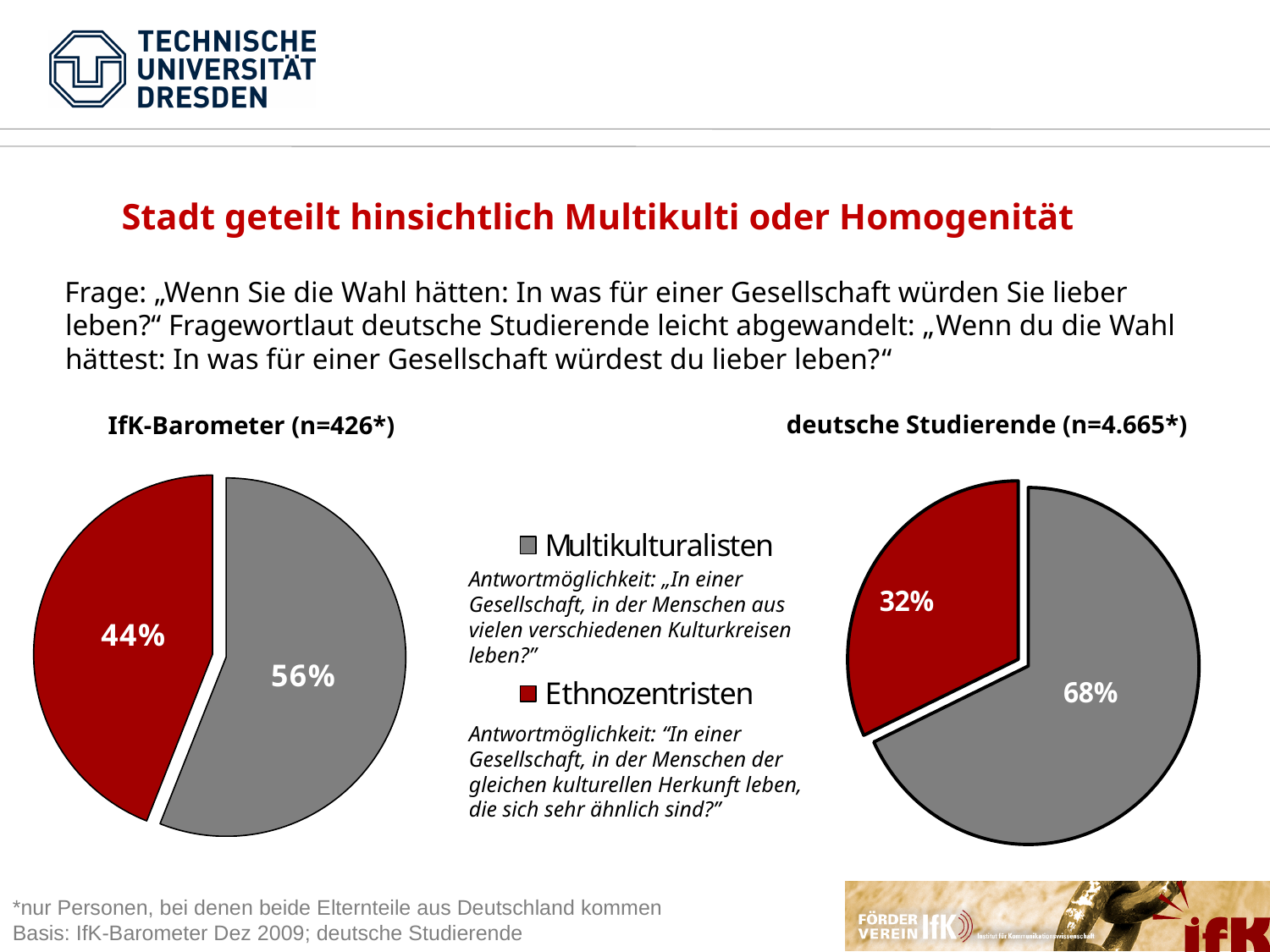
In the IfK-Barometer (n=426*) pie chart, which group has the larger share? Multikulturalisten Which colour represents the Ethnozentristen in the pie charts? Red In the deutsche Studierende (n=4.665*) pie chart, what share do the Multikulturalisten have? 68% In the IfK-Barometer (n=426*) pie chart, what is the difference in percentage points between Multikulturalisten and Ethnozentristen? 12 percentage points In the deutsche Studierende (n=4.665*) pie chart, what share do the Ethnozentristen have? 32% In the deutsche Studierende (n=4.665*) pie chart, which group has the smaller share? Ethnozentristen What type of chart is used on this slide? Pie chart In the deutsche Studierende (n=4.665*) pie chart, what is the difference in percentage points between Multikulturalisten and Ethnozentristen? 36 percentage points In the IfK-Barometer (n=426*) pie chart, what share do the Ethnozentristen have? 44% Is the Ethnozentristen share larger in the IfK-Barometer chart or in the deutsche Studierende chart? IfK-Barometer How many categories does the legend list? 2 In the IfK-Barometer (n=426*) pie chart, what share do the Multikulturalisten have? 56%